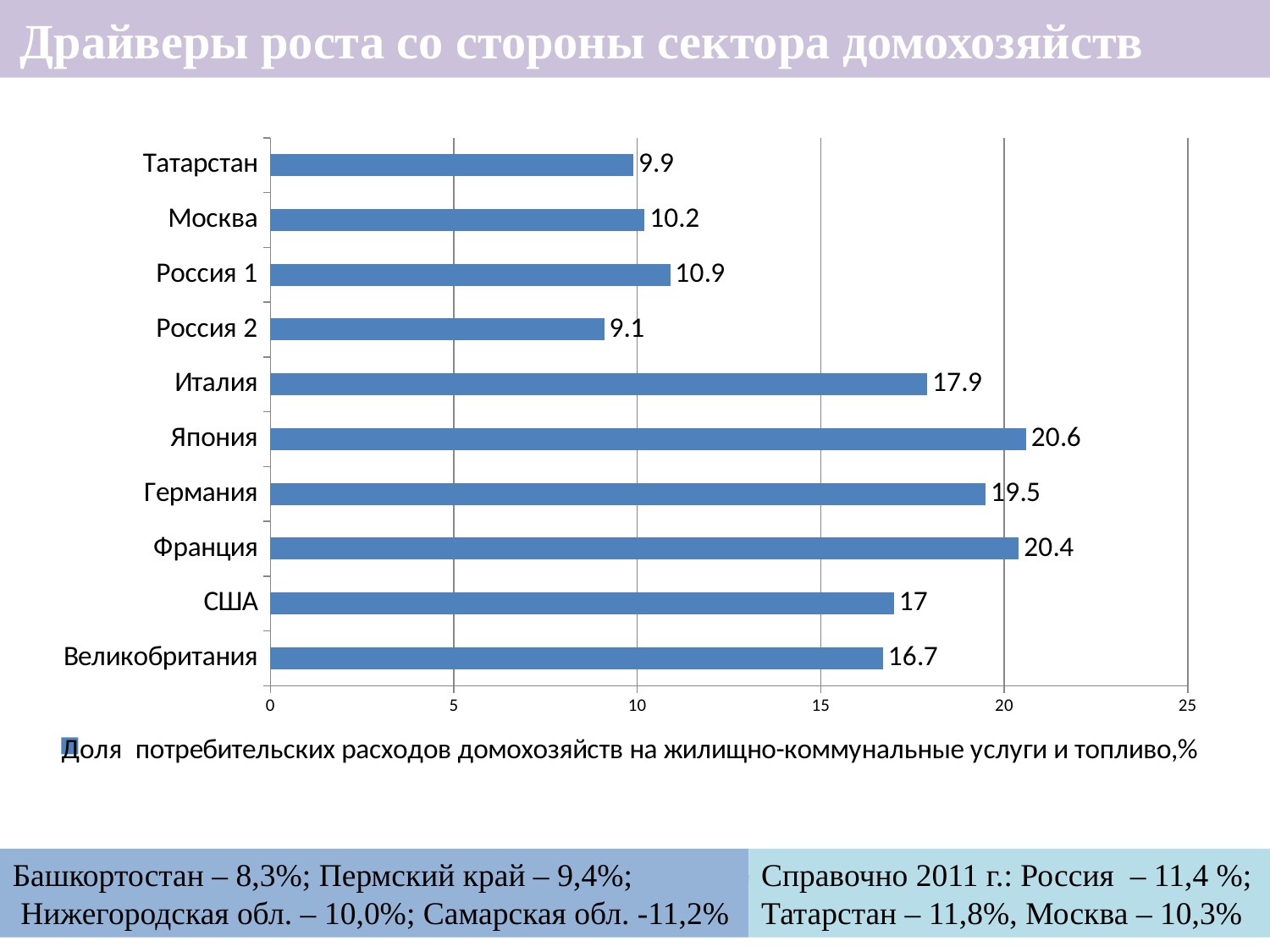
Is the value for Москва greater or less than 15? less What does the legend entry below the chart say? Доля потребительских расходов домохозяйств на жилищно-коммунальные услуги и топливо,% Which category has the lowest value? Россия 2 What is the value for Германия? 19.5 How many categories are shown in the chart? 10 What is the difference between the values for Россия 1 and Татарстан? 1 Which category has the highest value? Япония Which is larger, the value for Франция or the value for Великобритания? Франция What is the value for Россия 2? 9.1 What kind of chart is shown on the slide? bar chart What is the difference between the values for Италия and США? 0.9 What is the value for Япония? 20.6